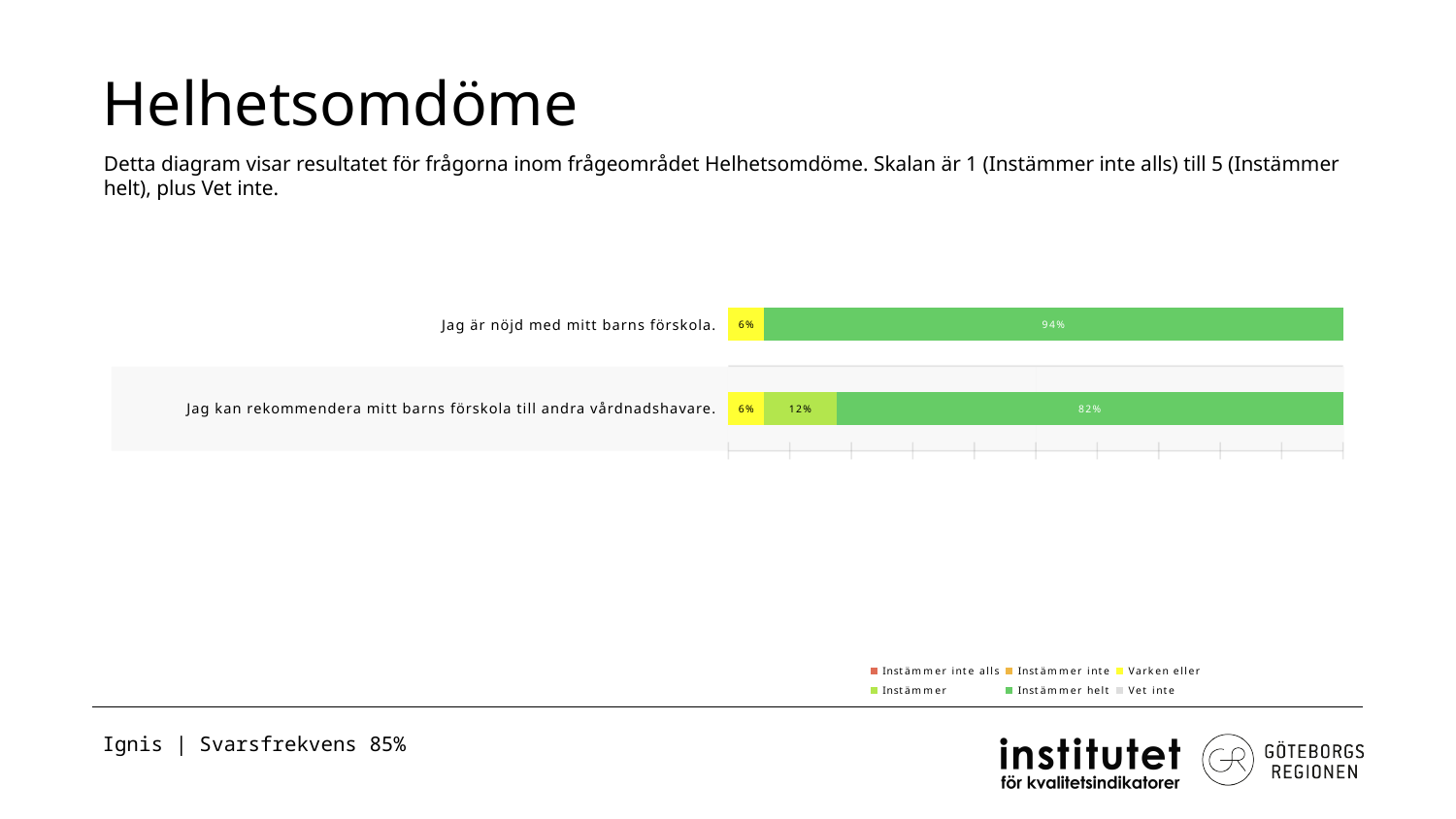
What is the difference between the 'Instämmer helt' values of the two statements? 12% How many categories (statements) are plotted in the chart? 2 What is the 'Instämmer' value for 'Jag kan rekommendera mitt barns förskola till andra vårdnadshavare.'? 12% What is the title of the slide containing the chart? Helhetsomdöme What kind of chart is shown on the slide? stacked bar chart What is the 'Varken eller' value for 'Jag är nöjd med mitt barns förskola.'? 6% What is the 'Instämmer helt' value for 'Jag kan rekommendera mitt barns förskola till andra vårdnadshavare.'? 82% What is the 'Instämmer helt' value for 'Jag är nöjd med mitt barns förskola.'? 94% How many series does the legend list? 6 Is the 'Instämmer helt' value for 'Jag är nöjd med mitt barns förskola.' larger or smaller than the 'Instämmer helt' value for 'Jag kan rekommendera mitt barns förskola till andra vårdnadshavare.'? larger Which statement has the higher 'Instämmer helt' share? Jag är nöjd med mitt barns förskola. What is the total of the labelled segments in the bar for 'Jag kan rekommendera mitt barns förskola till andra vårdnadshavare.'? 100%